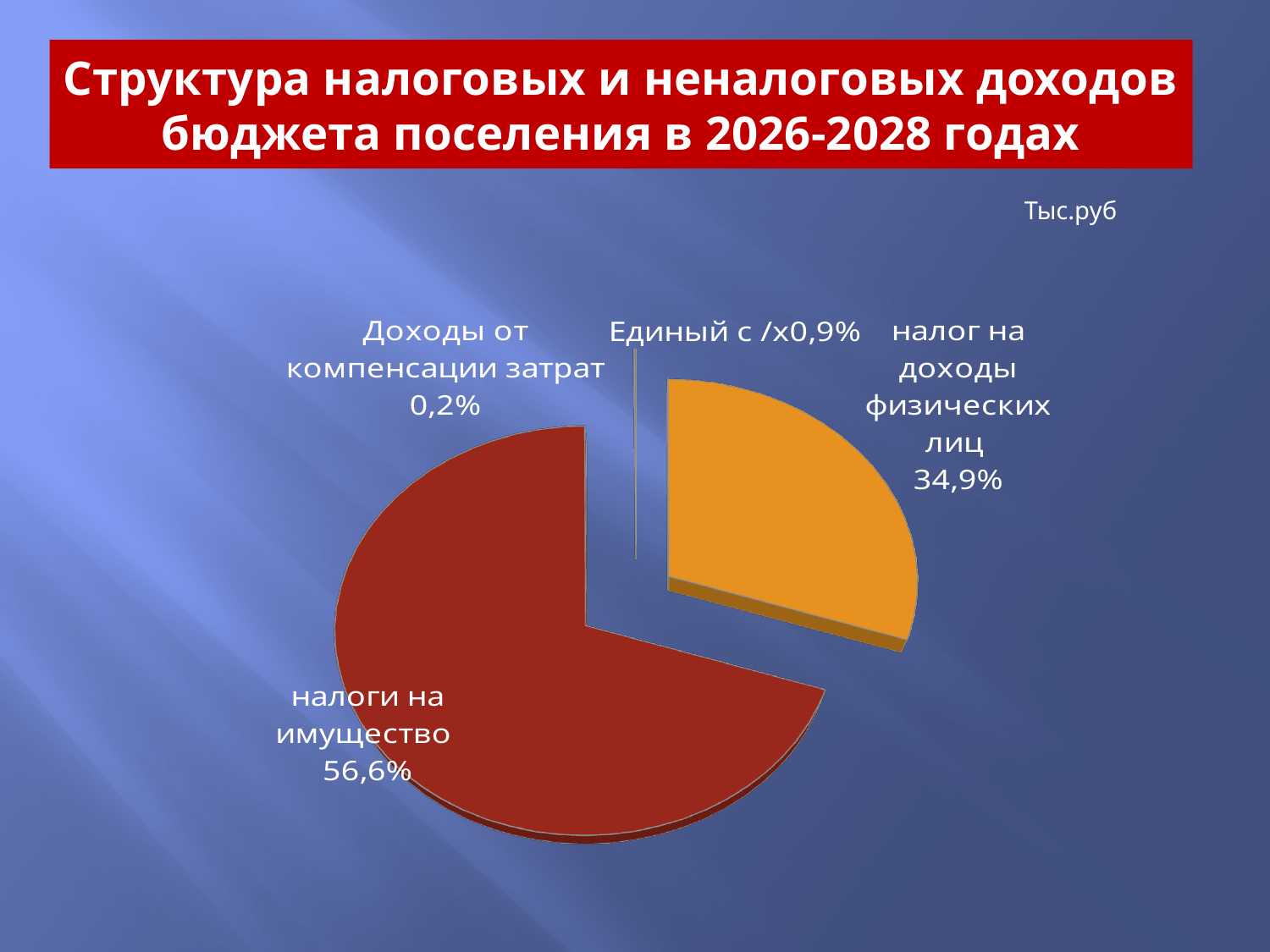
How many categories are labelled on the pie chart? 4 What share of the pie does налог на доходы физических лиц have? 34,9% What colour is the slice for налог на доходы физических лиц? orange What is the difference in percentage points between налоги на имущество and налог на доходы физических лиц? 21,7 Which category has the largest share of the pie? налоги на имущество What share of the pie does Единый с/х have? 0,9% What is the title of the slide? Структура налоговых и неналоговых доходов бюджета поселения в 2026-2028 годах What share of the pie does Доходы от компенсации затрат have? 0,2% What kind of chart is shown on the slide? pie chart Which category has the smallest share of the pie? Доходы от компенсации затрат What share of the pie does налоги на имущество have? 56,6% Which is larger: the share for Единый с/х or the share for Доходы от компенсации затрат? Единый с/х